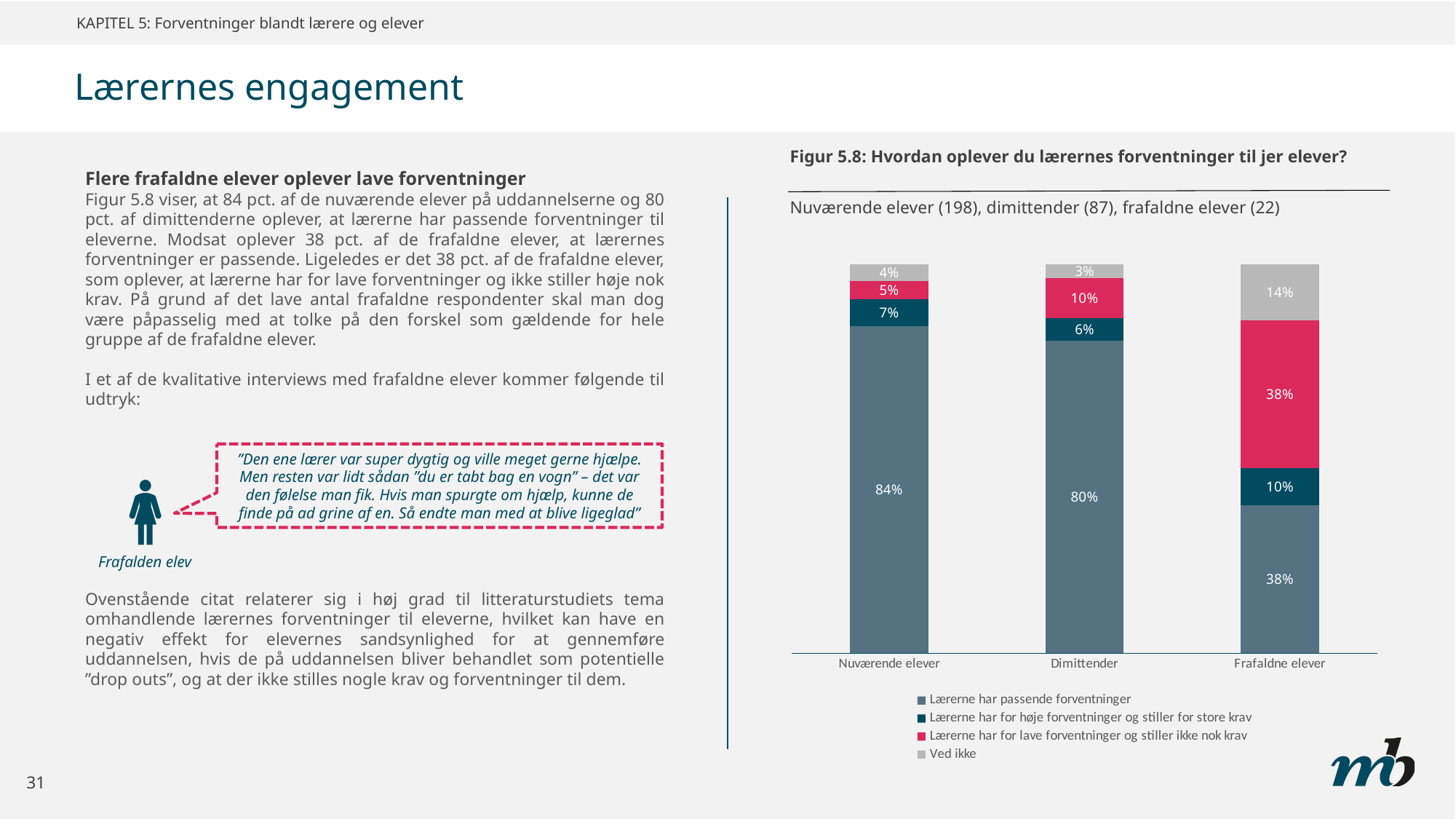
How many series does the legend list? 4 What is the difference between the 'Lærerne har passende forventninger' share for Nuværende elever and for Frafaldne elever? 46% How many groups (bars) are shown on the x axis? 3 Which is larger: the 'Lærerne har for lave forventninger og stiller ikke nok krav' share for Dimittender or for Frafaldne elever? Frafaldne elever What percentage of Nuværende elever answered 'Lærerne har passende forventninger'? 84% What percentage of Dimittender answered 'Lærerne har for lave forventninger og stiller ikke nok krav'? 10% Which group has the highest share answering 'Lærerne har passende forventninger'? Nuværende elever What is the total of the stacked bar for Dimittender? 99% What kind of chart is shown in Figur 5.8? Stacked bar chart What percentage of Frafaldne elever answered 'Lærerne har for høje forventninger og stiller for store krav'? 10% Which group has the lowest share answering 'Ved ikke'? Dimittender What percentage of Frafaldne elever answered 'Ved ikke'? 14%